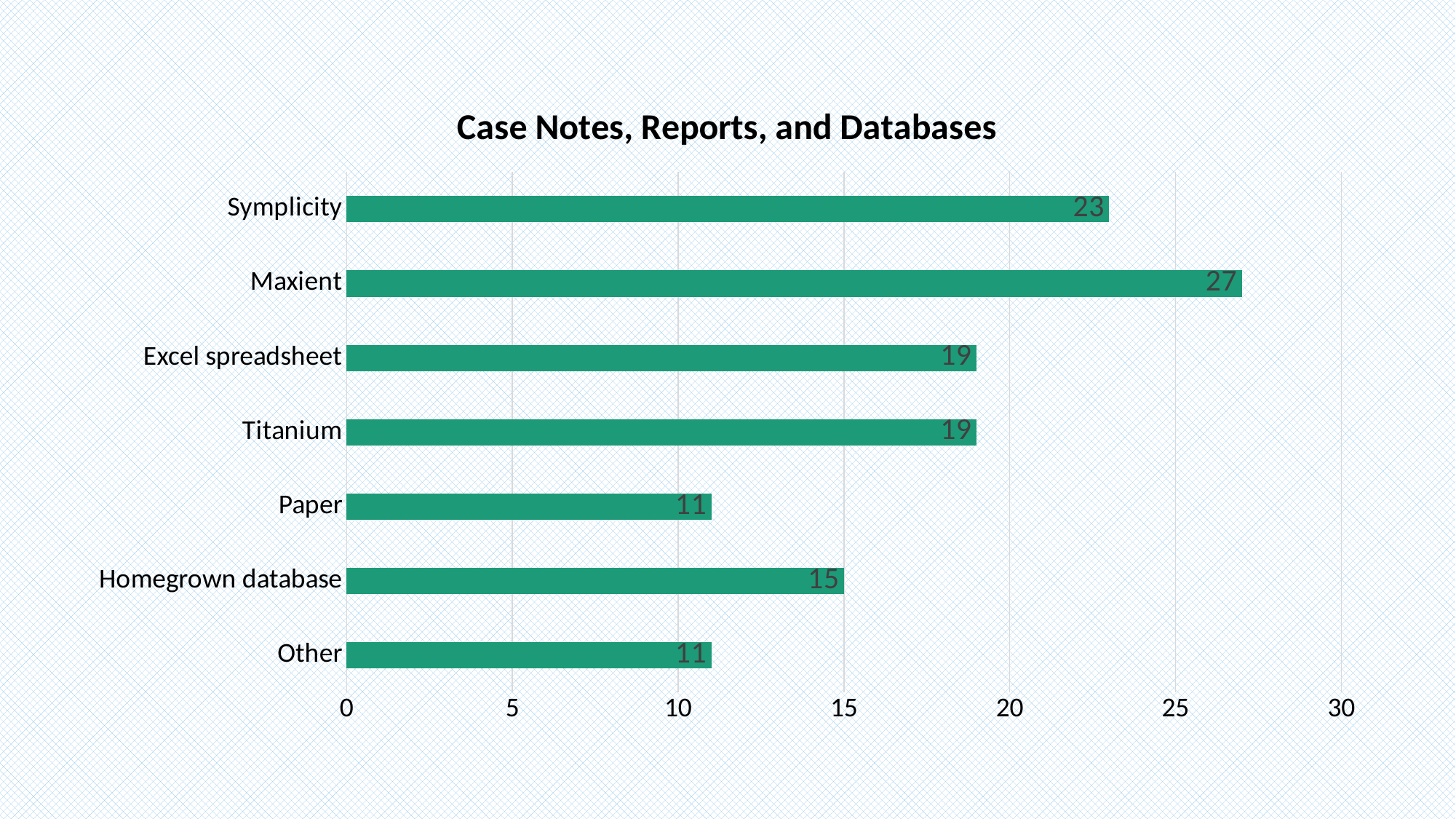
What is the value for Paper? 11 Which is larger, the value for Symplicity or the value for Titanium? Symplicity Is the value for Homegrown database greater or less than 20? less What is the title of the chart? Case Notes, Reports, and Databases What kind of chart is shown on the slide? bar chart What is the difference between the values for Excel spreadsheet and Homegrown database? 4 What is the value for Symplicity? 23 How many categories are shown in the chart? 7 Which category has the highest value? Maxient What is the difference between the values for Maxient and Symplicity? 4 What is the value for Maxient? 27 What is the value for Homegrown database? 15